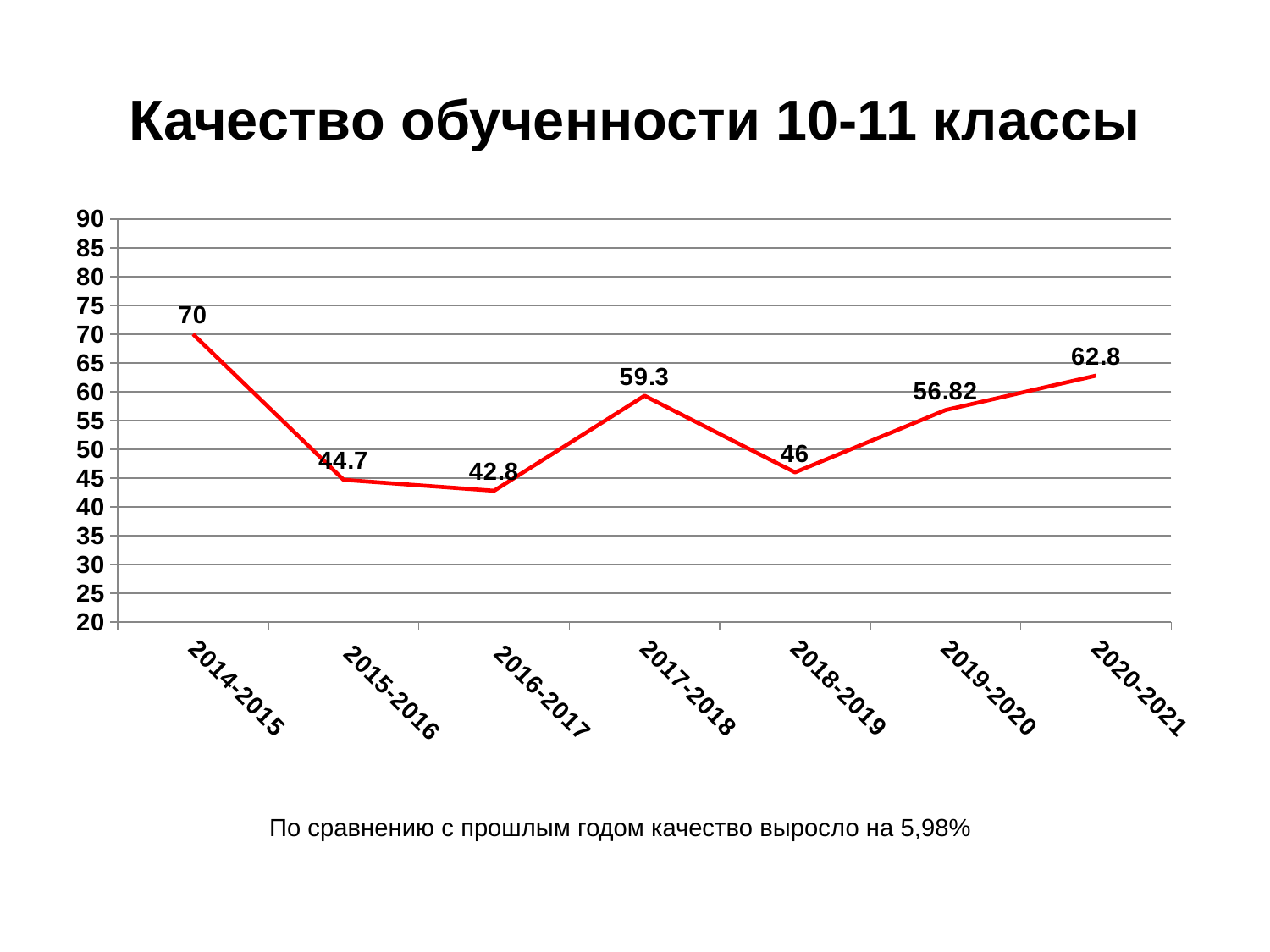
Is the value for 2018-2019 greater or less than 50? less What is the value for 2020-2021? 62.8 Which is larger, the value for 2015-2016 or the value for 2017-2018? 2017-2018 What is the value for 2016-2017? 42.8 What is the value for 2019-2020? 56.82 How many years are plotted on the chart? 7 What is the difference between the values for 2017-2018 and 2018-2019? 13.3 What kind of chart is shown on the slide? line chart Which year has the lowest value? 2016-2017 What is the value for 2014-2015? 70 What is the title of the chart? Качество обученности 10-11 классы Which year has the highest value? 2014-2015